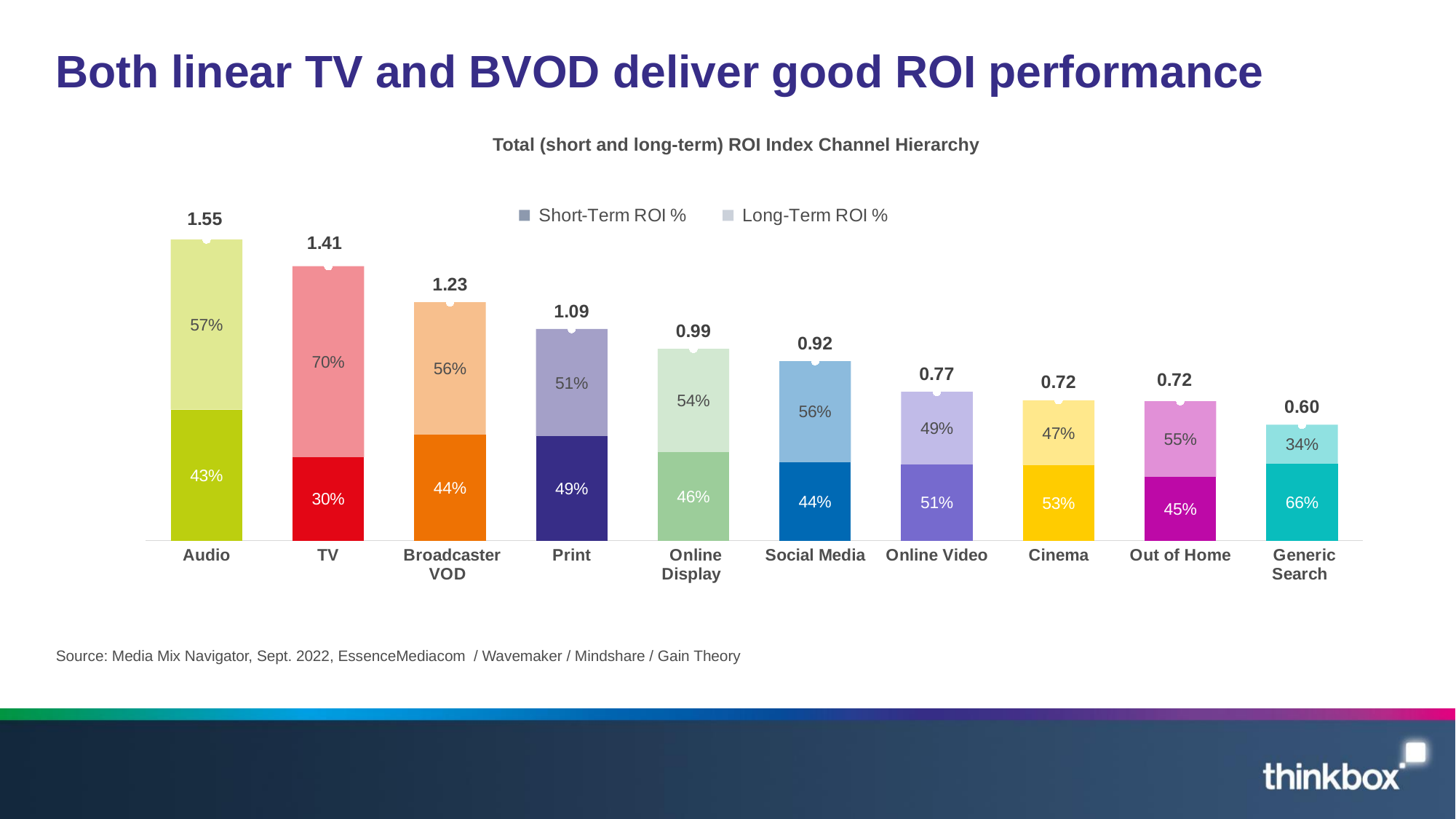
Which channel has the lowest total ROI index? Generic Search Do the total ROI index values rise or fall from left to right along the x axis? Fall How many series does the legend list? 2 What is the difference between the total ROI index for Audio and for TV? 0.14 Which channel has the highest total ROI index? Audio What is the Long-Term ROI % for Broadcaster VOD? 56% What is the Short-Term ROI % for Generic Search? 66% Which has a higher total ROI index, Print or Online Display? Print What kind of chart is shown on the slide? Stacked bar chart How many channels are shown on the x axis? 10 What is the total ROI index shown above the bar for Audio? 1.55 What is the Short-Term ROI % for TV? 30%